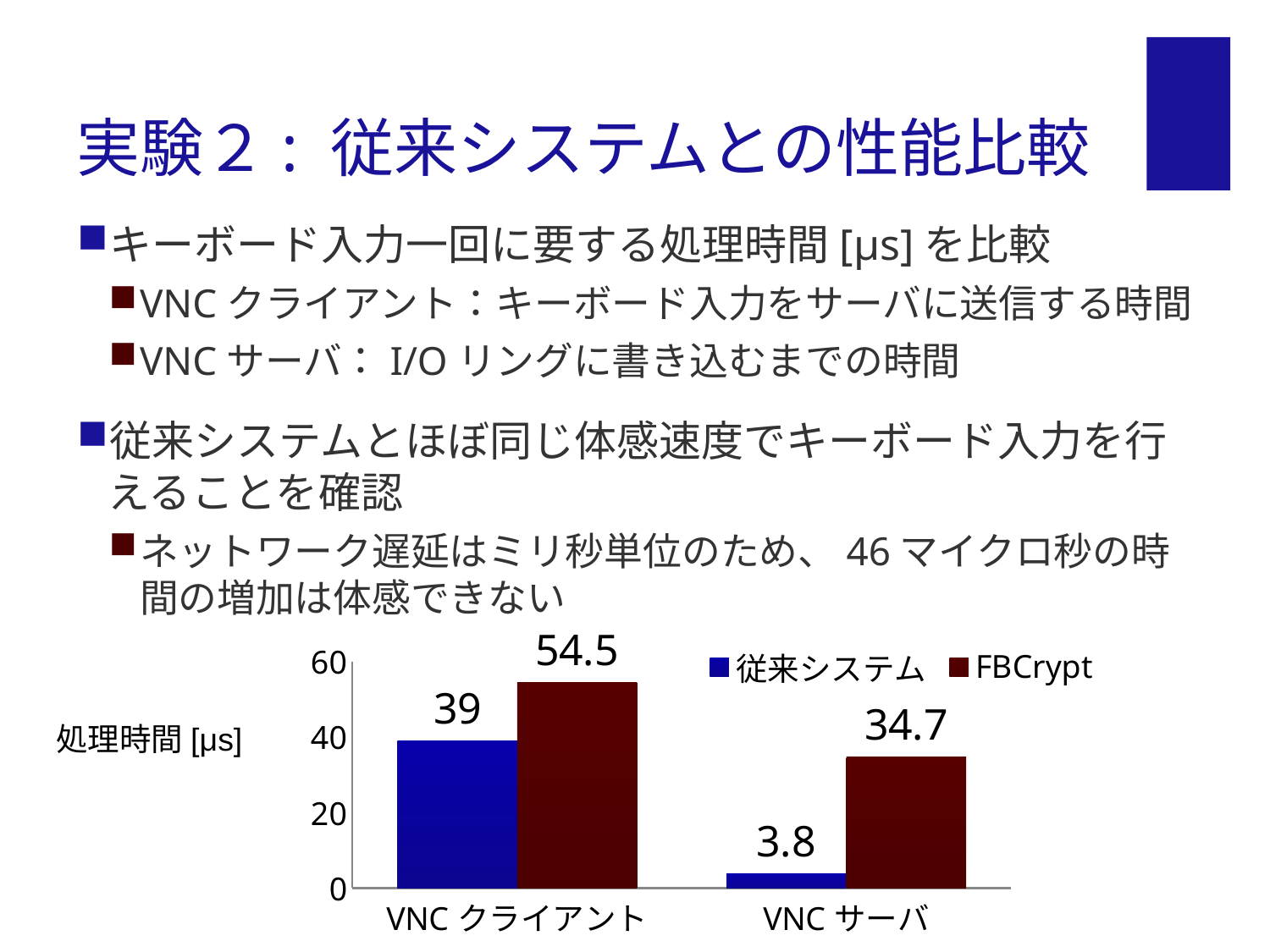
What is the value for 従来システム in the VNC サーバ category? 3.8 What kind of chart is shown on the slide? bar chart What is the value for FBCrypt in the VNC クライアント category? 54.5 Which category has the lowest 従来システム value? VNC サーバ What is the difference between the FBCrypt and 従来システム values for VNC クライアント? 15.5 Which is larger for VNC サーバ: 従来システム or FBCrypt? FBCrypt What is the difference between the FBCrypt and 従来システム values for VNC サーバ? 30.9 What is the value for 従来システム in the VNC クライアント category? 39 How many series does the legend list? 2 How many categories are shown on the x axis? 2 What is the value for FBCrypt in the VNC サーバ category? 34.7 Which category has the highest FBCrypt value? VNC クライアント